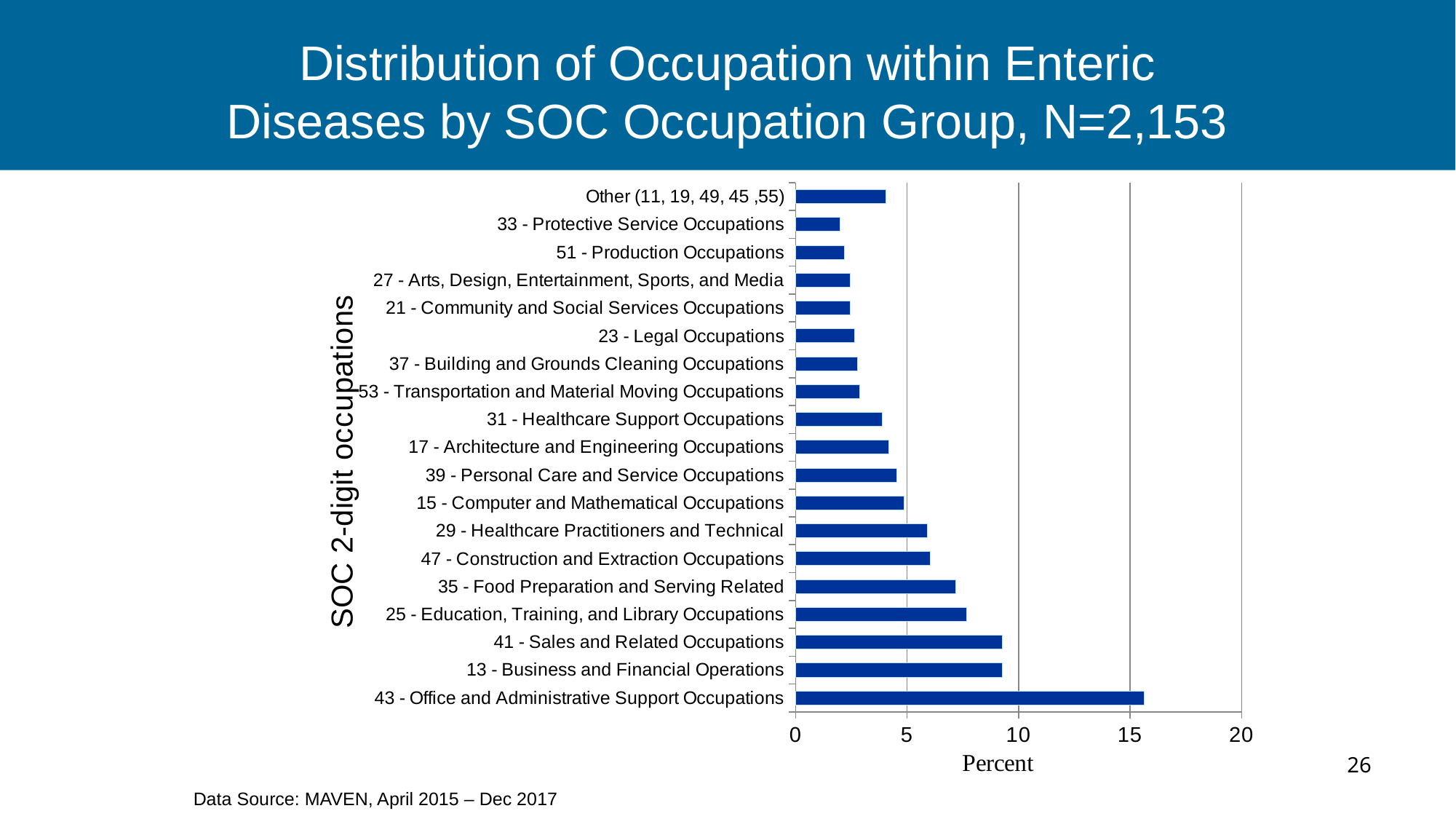
What kind of chart is shown on the slide? bar chart Which occupation group has the highest percentage? 43 - Office and Administrative Support Occupations What is the title of the horizontal axis? Percent Which is larger: the value for 47 - Construction and Extraction Occupations or 31 - Healthcare Support Occupations? 47 - Construction and Extraction Occupations Is the value for 41 - Sales and Related Occupations greater or less than 10? less What is the title of the vertical axis? SOC 2-digit occupations Which is larger: the value for 43 - Office and Administrative Support Occupations or 41 - Sales and Related Occupations? 43 - Office and Administrative Support Occupations Is the value for Other (11, 19, 49, 45, 55) greater or less than 5? less Is the value for 43 - Office and Administrative Support Occupations greater or less than 15? greater How many occupation categories are plotted on the chart? 19